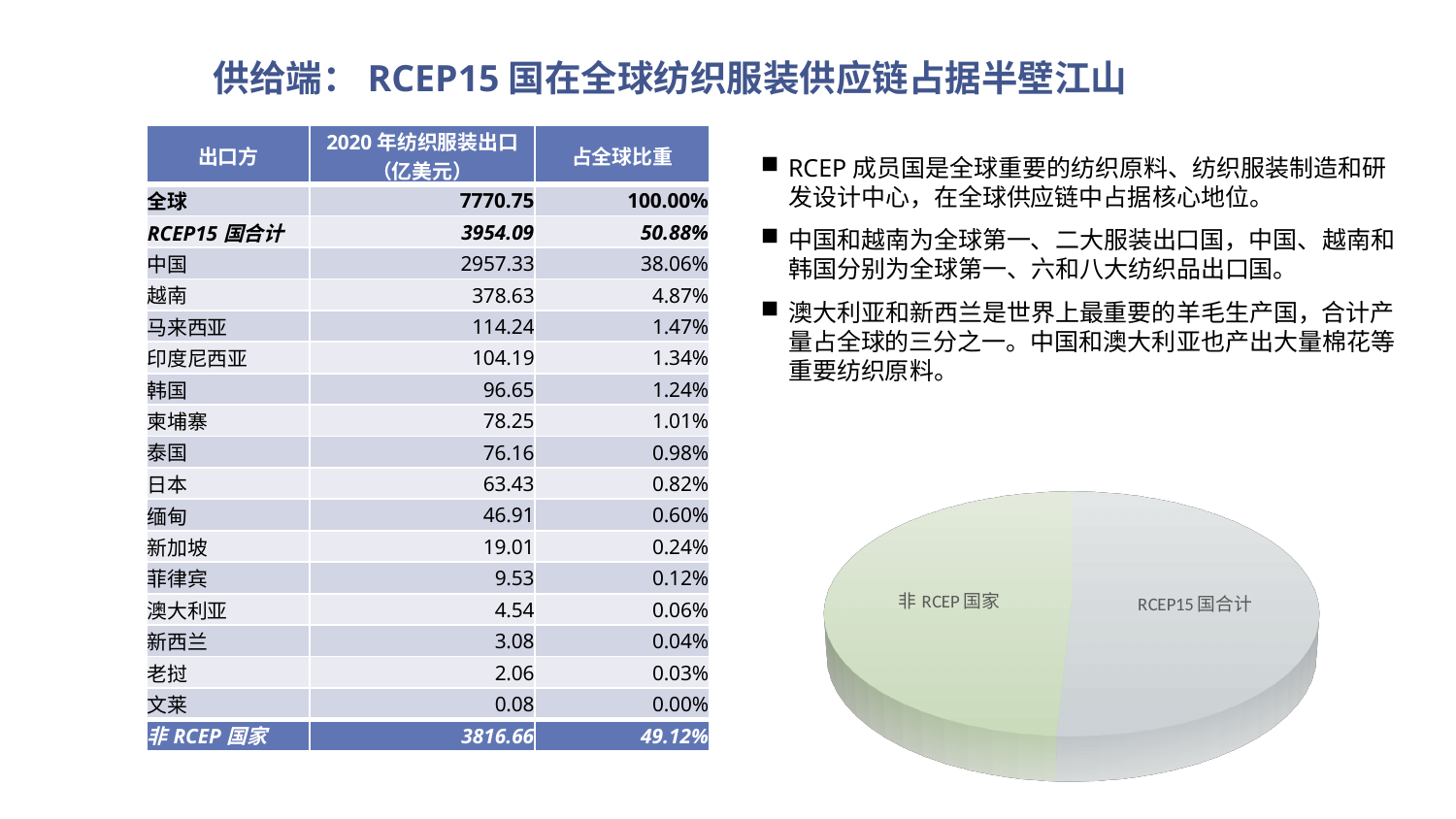
Which slice of the pie chart is coloured green? 非RCEP国家 What are the labels of the two slices in the pie chart? 非RCEP国家 and RCEP15国合计 What kind of chart is shown on the right side of the slide? pie chart According to the slide, what share of the pie does 非RCEP国家 represent? 49.12% According to the slide, what share of the pie does RCEP15国合计 represent? 50.88% How many slices does the pie chart have? 2